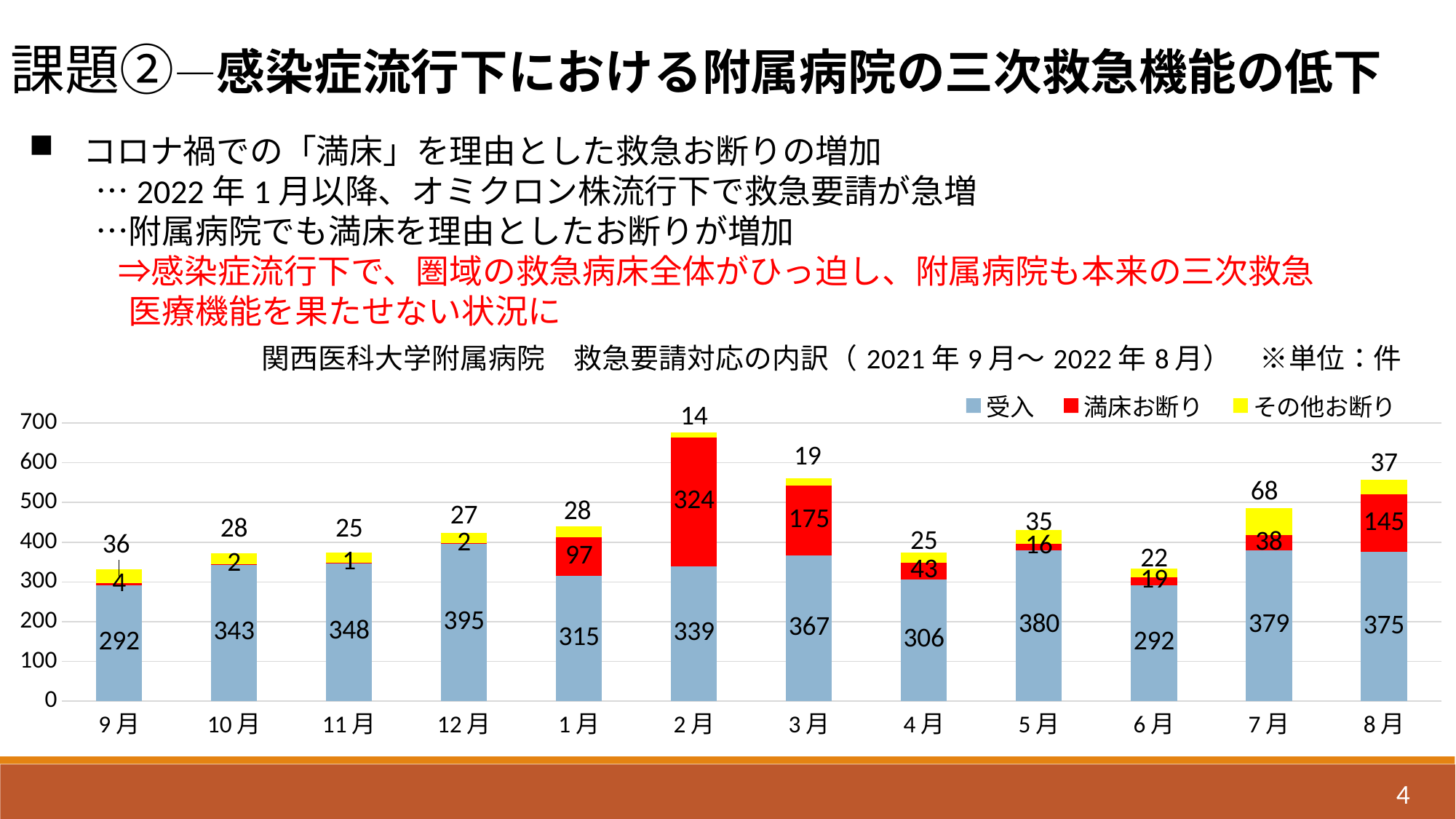
What kind of chart is shown on the slide? Stacked bar chart Which is larger, the 受入 value for 12月 or for 5月? 12月 What is the total of the stacked bar for 9月? 332 What is the 受入 value for 2月? 339 What is the 満床お断り value for 8月? 145 How many months are shown on the x axis? 12 Which month has the highest 満床お断り value? 2月 What is the difference between the 満床お断り values for 2月 and 3月? 149 Which month has the lowest 満床お断り value? 11月 How many series does the legend list? 3 What is the その他お断り value for 7月? 68 What is the total of the stacked bar for 2月? 677